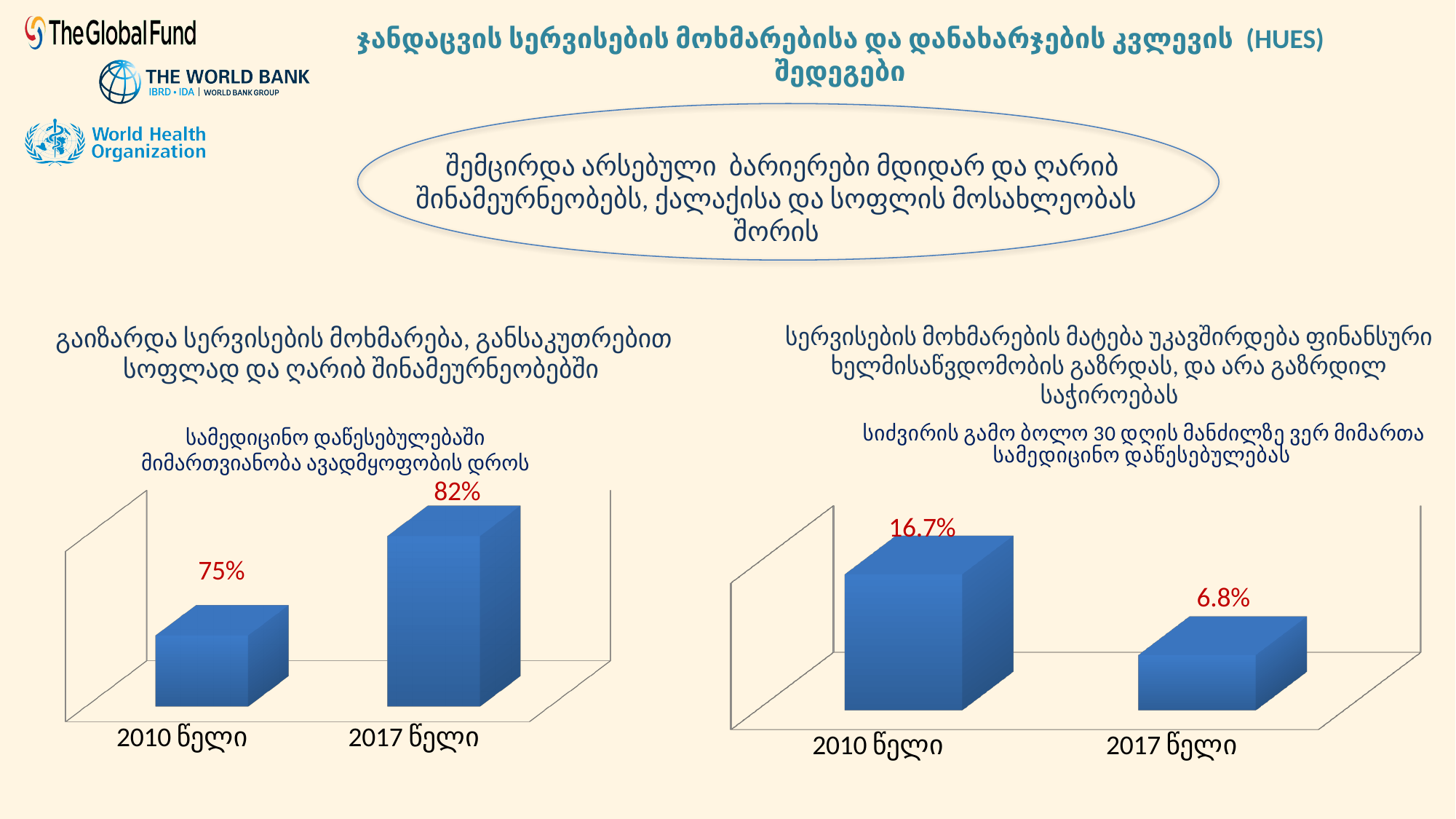
In the left chart, what is the value for 2017 წელი? 82% In the left chart, what is the difference between the 2017 წელი and 2010 წელი values? 7% What type of chart is the right chart? bar chart In the left chart, which year has the higher value? 2017 წელი In the right chart, what is the value for 2017 წელი? 6.8% In the right chart, what is the difference between the 2010 წელი and 2017 წელი values? 9.9% In the right chart, which year has the lower value? 2017 წელი How many bars does the left chart have? 2 In the right chart, what is the value for 2010 წელი? 16.7% In the right chart, is the value for 2010 წელი larger or smaller than the value for 2017 წელი? larger In the left chart, what is the value for 2010 წელი? 75% In the right chart, do the values rise or fall from 2010 წელი to 2017 წელი? fall